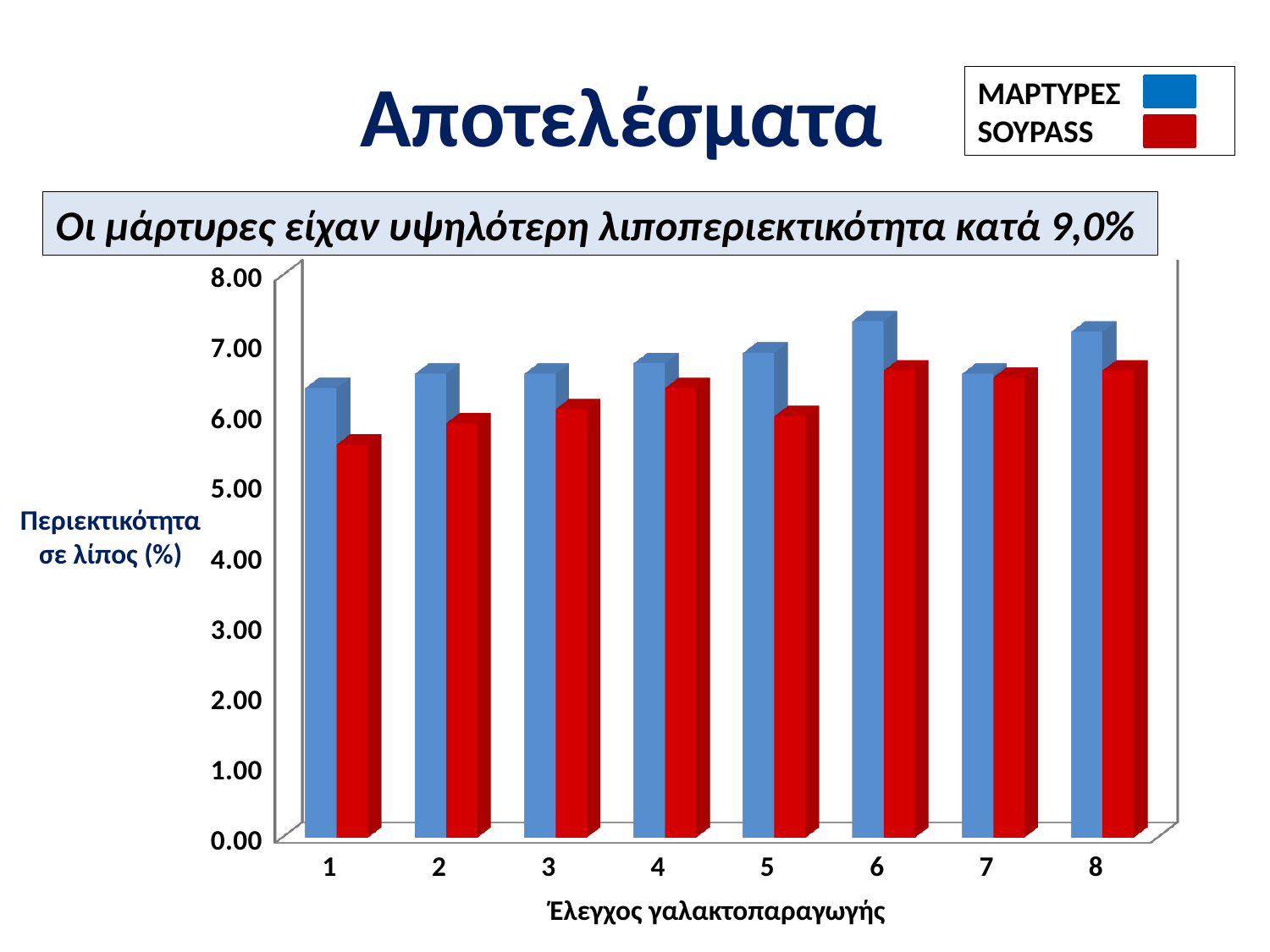
How many milk production checks (categories) are shown on the x axis? 8 What is the label of the y axis? Περιεκτικότητα σε λίπος (%) Is the ΜΑΡΤΥΡΕΣ value for check 6 greater or less than 7.00? greater For check 1, which series has the larger value, ΜΑΡΤΥΡΕΣ or SOYPASS? ΜΑΡΤΥΡΕΣ Is the SOYPASS value for check 6 greater or less than 7.00? less For which check is the SOYPASS value lowest? 1 Is the SOYPASS value for check 1 greater or less than 6.00? less Which series does the red colour represent in the legend? SOYPASS Which SOYPASS value is larger, check 1 or check 6? check 6 What kind of chart is shown on the slide? bar chart How many series does the legend list? 2